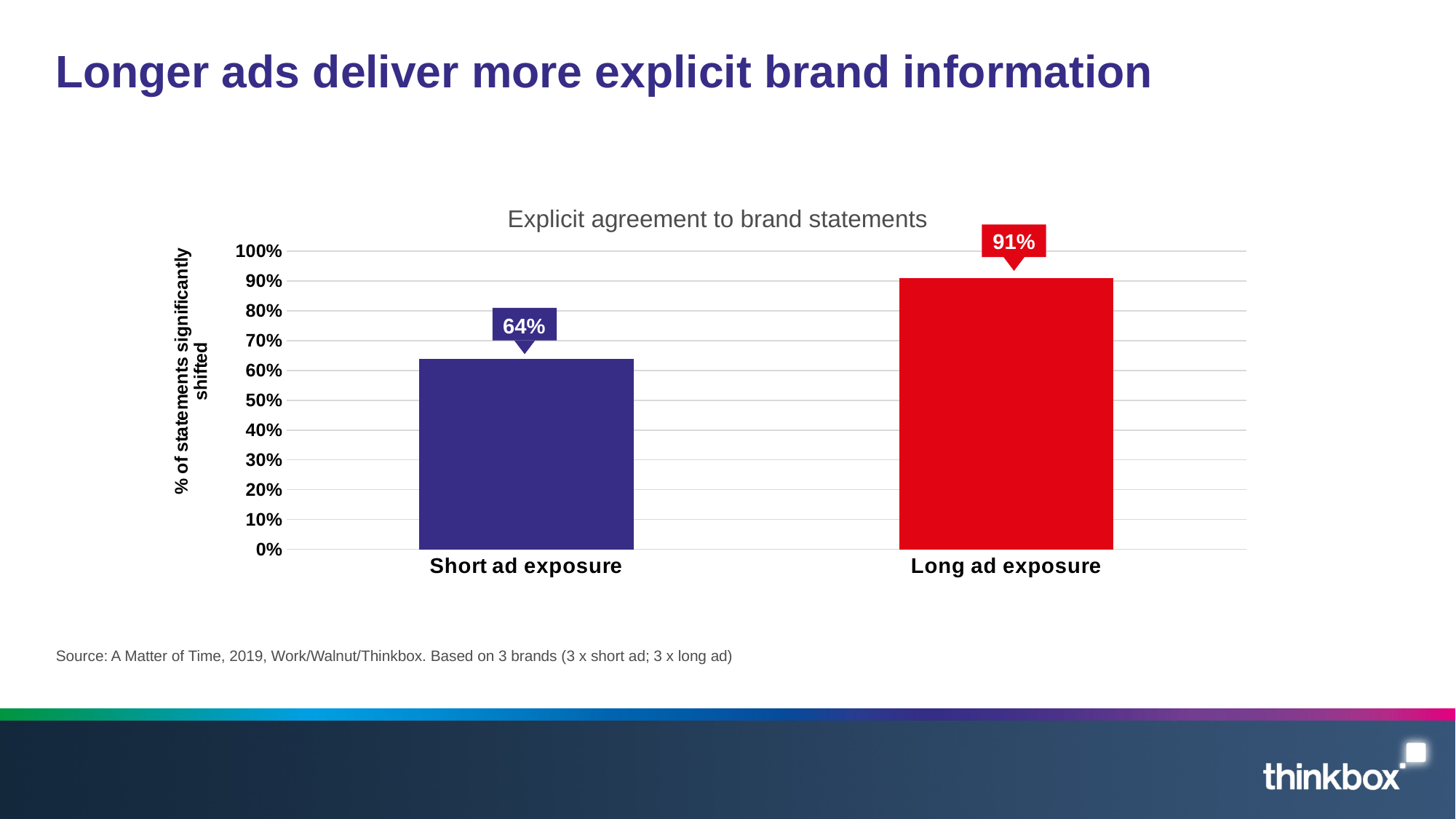
What is the title of the chart? Explicit agreement to brand statements Is the value for Short ad exposure greater or less than 70%? less How many categories are shown on the chart? 2 Which category has the lowest value? Short ad exposure What is the value for Long ad exposure? 91% Which category has the highest value? Long ad exposure What is the label on the vertical axis of the chart? % of statements significantly shifted What kind of chart is shown on the slide? Bar chart Is the value for Long ad exposure greater or less than 80%? greater What is the value for Short ad exposure? 64% Which is larger, the value for Short ad exposure or Long ad exposure? Long ad exposure What is the difference between the values for Long ad exposure and Short ad exposure? 27%